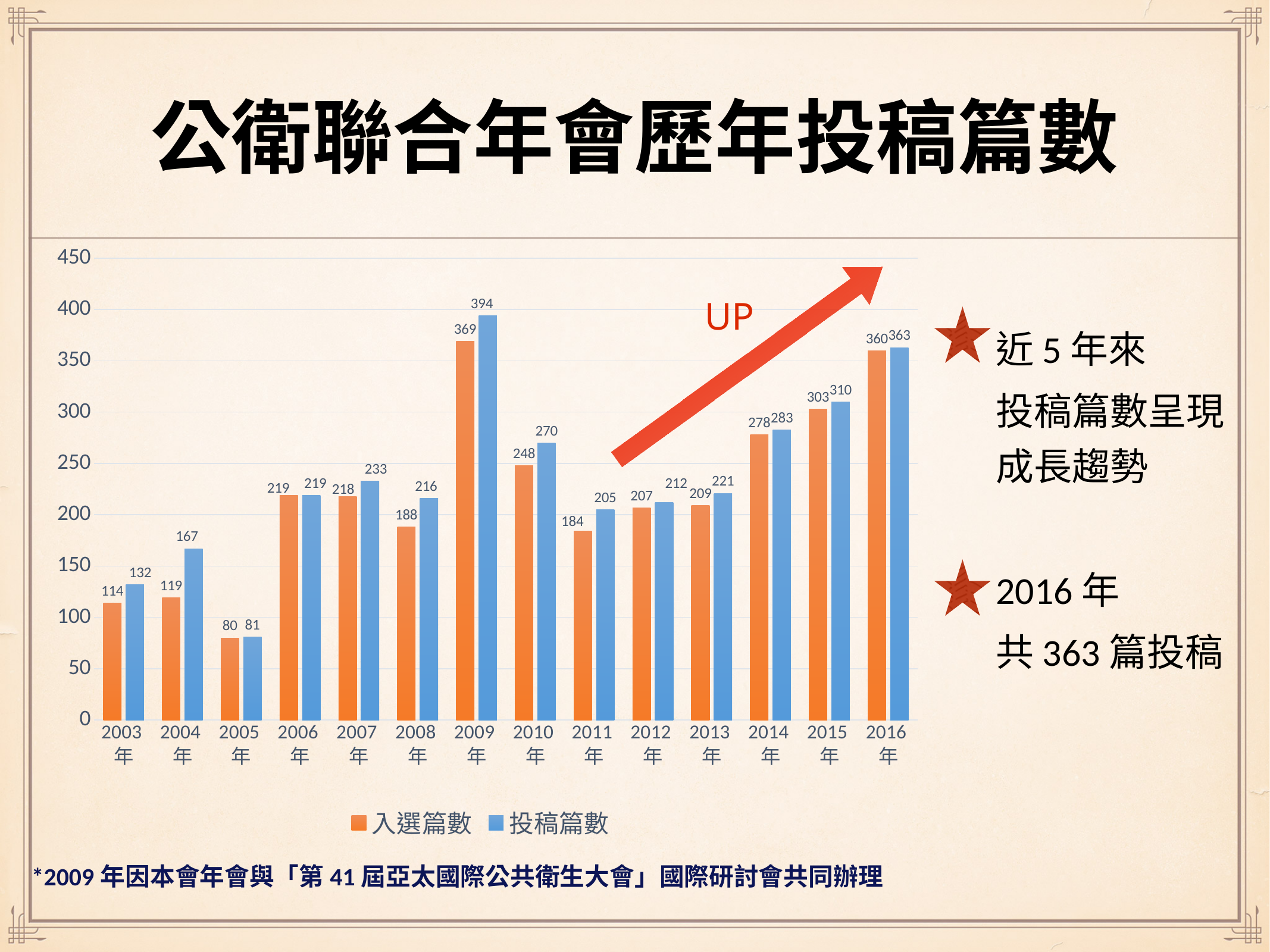
Which is larger, 投稿篇數 in 2015年 or 投稿篇數 in 2014年? 2015年 Which series is shown in orange in the legend? 入選篇數 How many series does the legend list? 2 What is the value of 投稿篇數 for 2004年? 167 Do the 投稿篇數 values rise or fall from 2012年 to 2016年? rise What is the value of 入選篇數 for 2016年? 360 Which year has the highest 投稿篇數? 2009年 How many years are shown on the x axis? 14 Which year has the lowest 入選篇數? 2005年 What type of chart is shown on the slide? bar chart What is the difference between 投稿篇數 and 入選篇數 in 2008年? 28 What is the value of 投稿篇數 for 2009年? 394